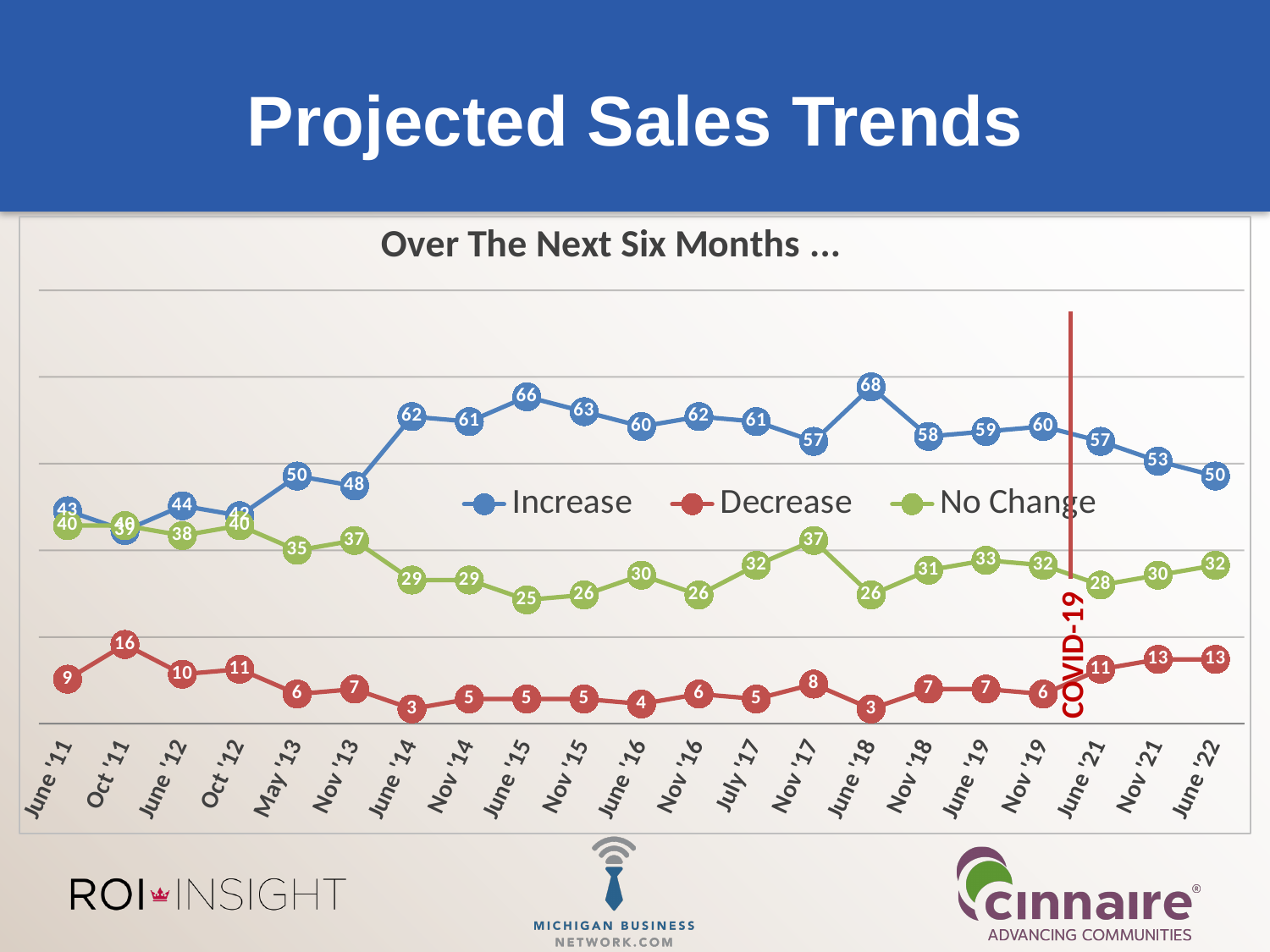
At which date does the Decrease series reach its highest value? Oct '11 What is the title of the chart? Over The Next Six Months ... How many dates are plotted along the x axis? 21 At which date does the No Change series reach its lowest value? June '15 What is the value of the Decrease series for Nov '21? 13 Which is larger: the No Change value for Nov '17 or the No Change value for June '18? Nov '17 What is the value of the Increase series for June '18? 68 What is the difference between the Increase value for June '18 and the Increase value for June '22? 18 At which date does the Increase series reach its highest value? June '18 What is the value of the No Change series for June '15? 25 How many series does the legend list? 3 What type of chart is shown on the slide? line chart